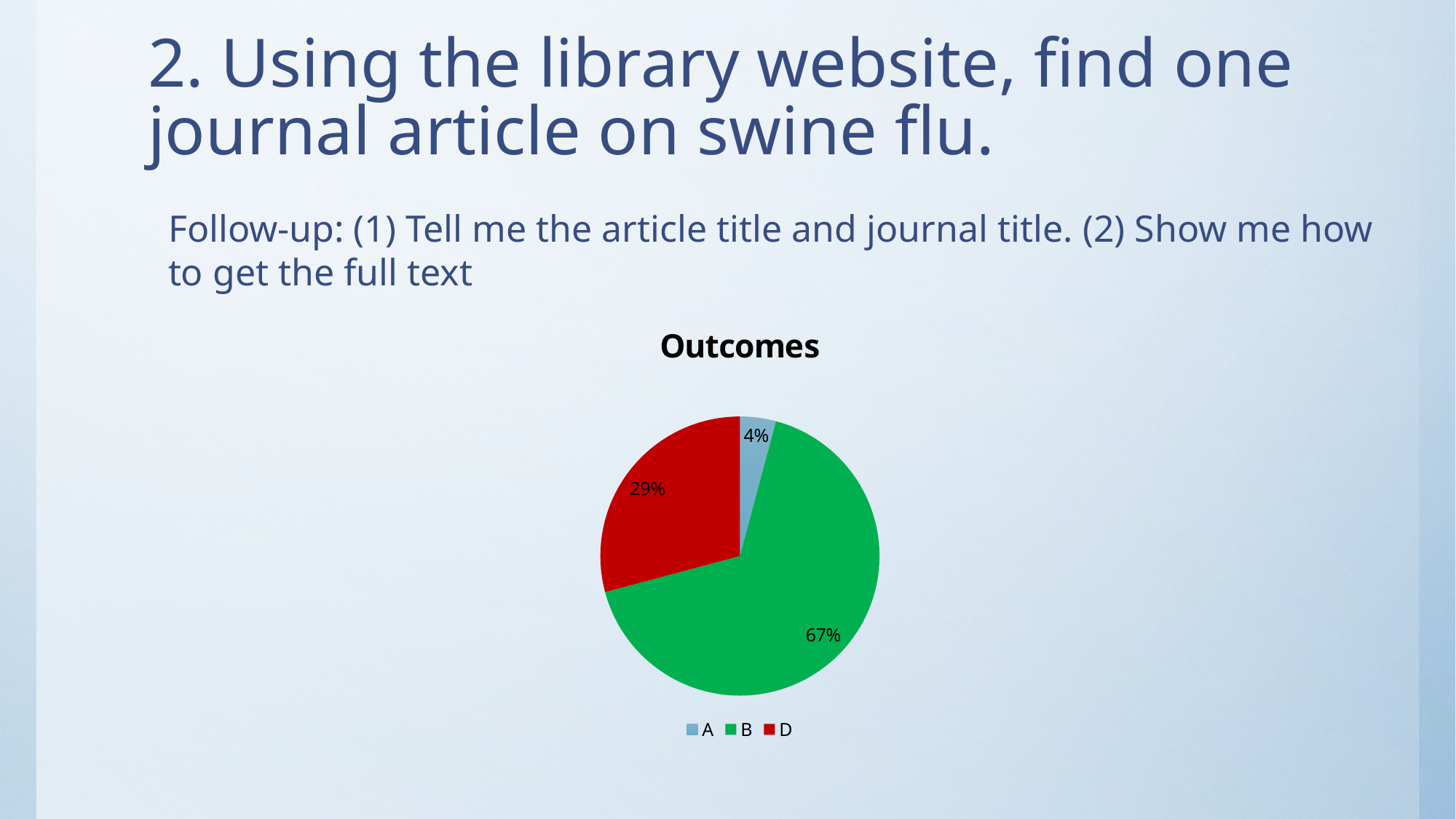
What share of the pie does category A have? 4% How many categories does the legend list? 3 What share of the pie does category B have? 67% What share of the pie does category D have? 29% What is the difference in percentage points between the shares of D and A? 25 What colour is the slice for category D? red Which category has the largest slice of the pie? B What kind of chart is shown on the slide? pie chart Which category has the smallest slice of the pie? A What is the title of the chart? Outcomes Which is larger, the share for D or the share for A? D What is the difference in percentage points between the shares of B and D? 38